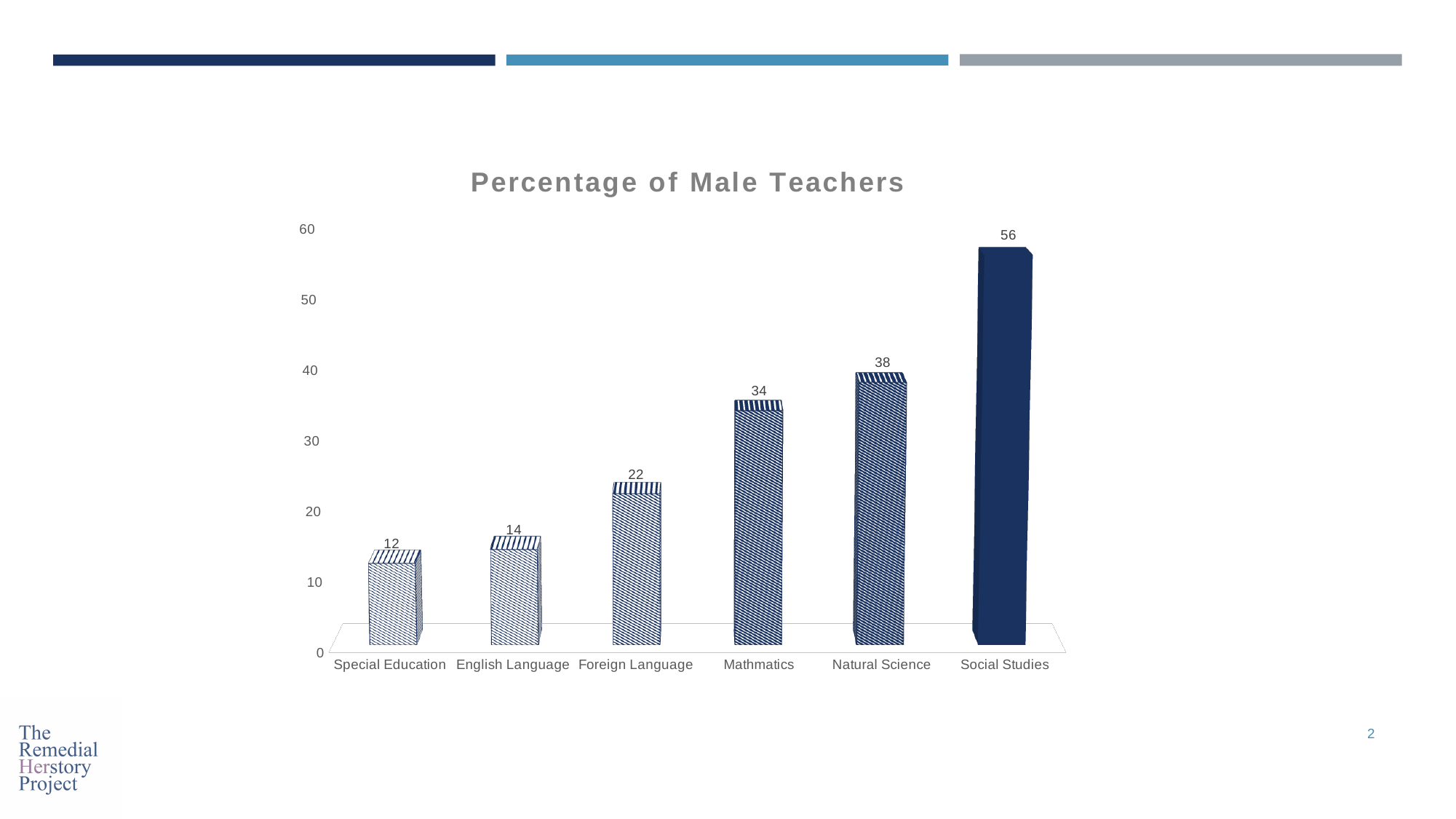
What is the title of the chart? Percentage of Male Teachers What is the value for Natural Science? 38 What is the difference between the values for Mathmatics and English Language? 20 What is the value for Social Studies? 56 What is the value for Foreign Language? 22 What is the value for Special Education? 12 Which is larger, the value for Foreign Language or the value for Mathmatics? Mathmatics What kind of chart is this? Bar chart Which category has the lowest value? Special Education Which category has the highest value? Social Studies How many categories are shown on the x axis? 6 What is the difference between the values for Social Studies and Natural Science? 18